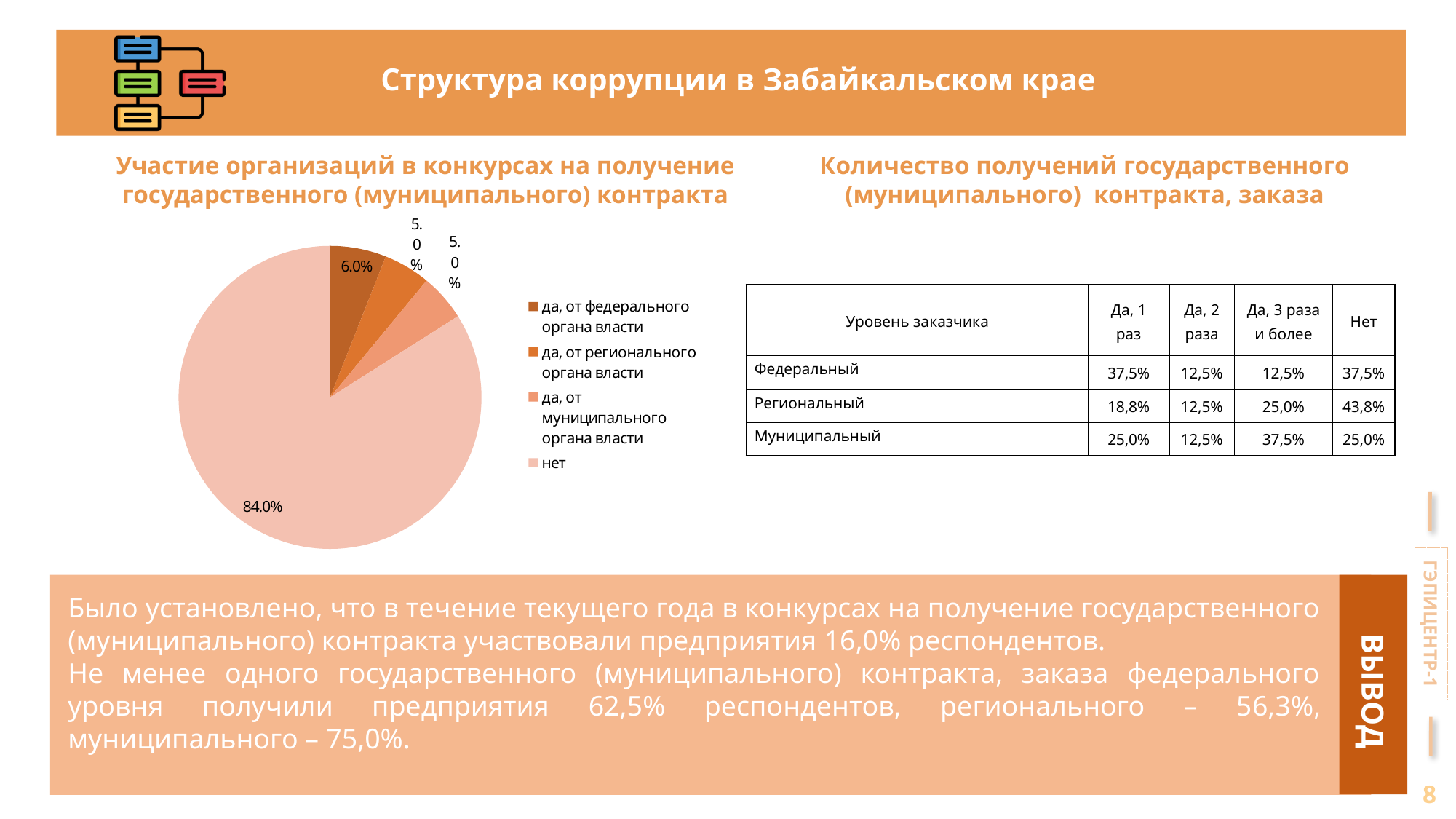
In the pie chart, which category has the largest share? нет What is the title of the pie chart on the slide? Участие организаций в конкурсах на получение государственного (муниципального) контракта In the pie chart, what is the combined share of the three "да" categories? 16.0% In the pie chart, what is the value for "да, от регионального органа власти"? 5.0% What kind of chart is shown under the title "Участие организаций в конкурсах на получение государственного (муниципального) контракта"? pie chart In the pie chart, what is the value for "да, от муниципального органа власти"? 5.0% In the pie chart, what is the value for "да, от федерального органа власти"? 6.0% How many slices does the pie chart have? 4 How many entries does the legend of the pie chart list? 4 In the pie chart, what is the value for "нет"? 84.0% In the pie chart, what is the difference between the share for "нет" and the share for "да, от федерального органа власти"? 78.0% In the pie chart, which is larger: "да, от федерального органа власти" or "да, от регионального органа власти"? да, от федерального органа власти